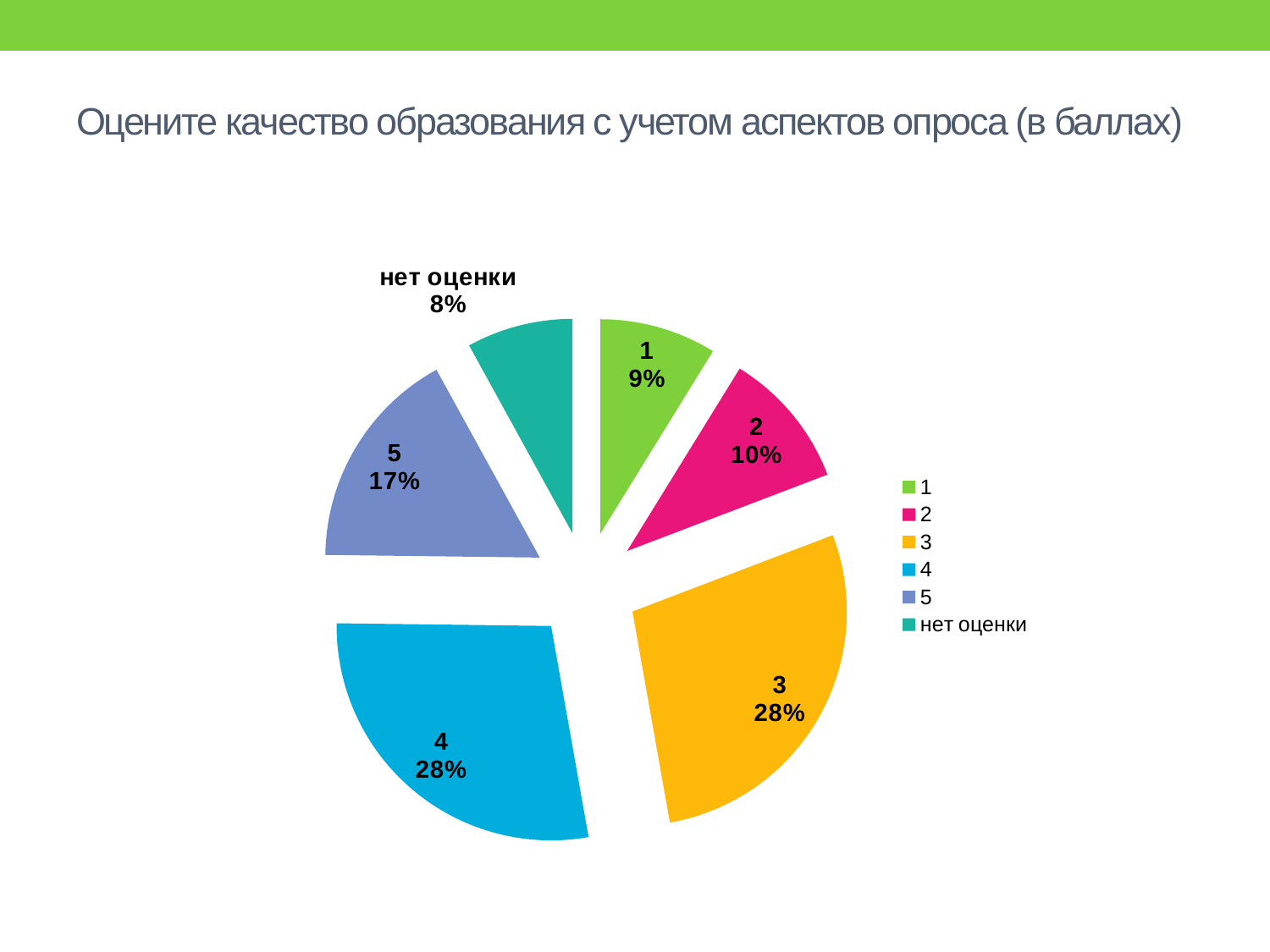
What percentage is shown for the slice labelled "нет оценки"? 8% What type of chart is shown on the slide? Pie chart What share of the pie does the slice labelled "5" represent? 17% How many entries does the legend list? 6 What is the difference in percentage points between the slices labelled "3" and "5"? 11 What percentage is shown for the slice labelled "2"? 10% What is the title of the chart? Оцените качество образования с учетом аспектов опроса (в баллах) How many categories does the pie chart contain? 6 What percentage is shown for the slice labelled "1"? 9% Which slice is larger, "5" or "2"? 5 What is the difference in percentage points between the slices labelled "2" and "1"? 1 Which category has the smallest share of the pie? нет оценки